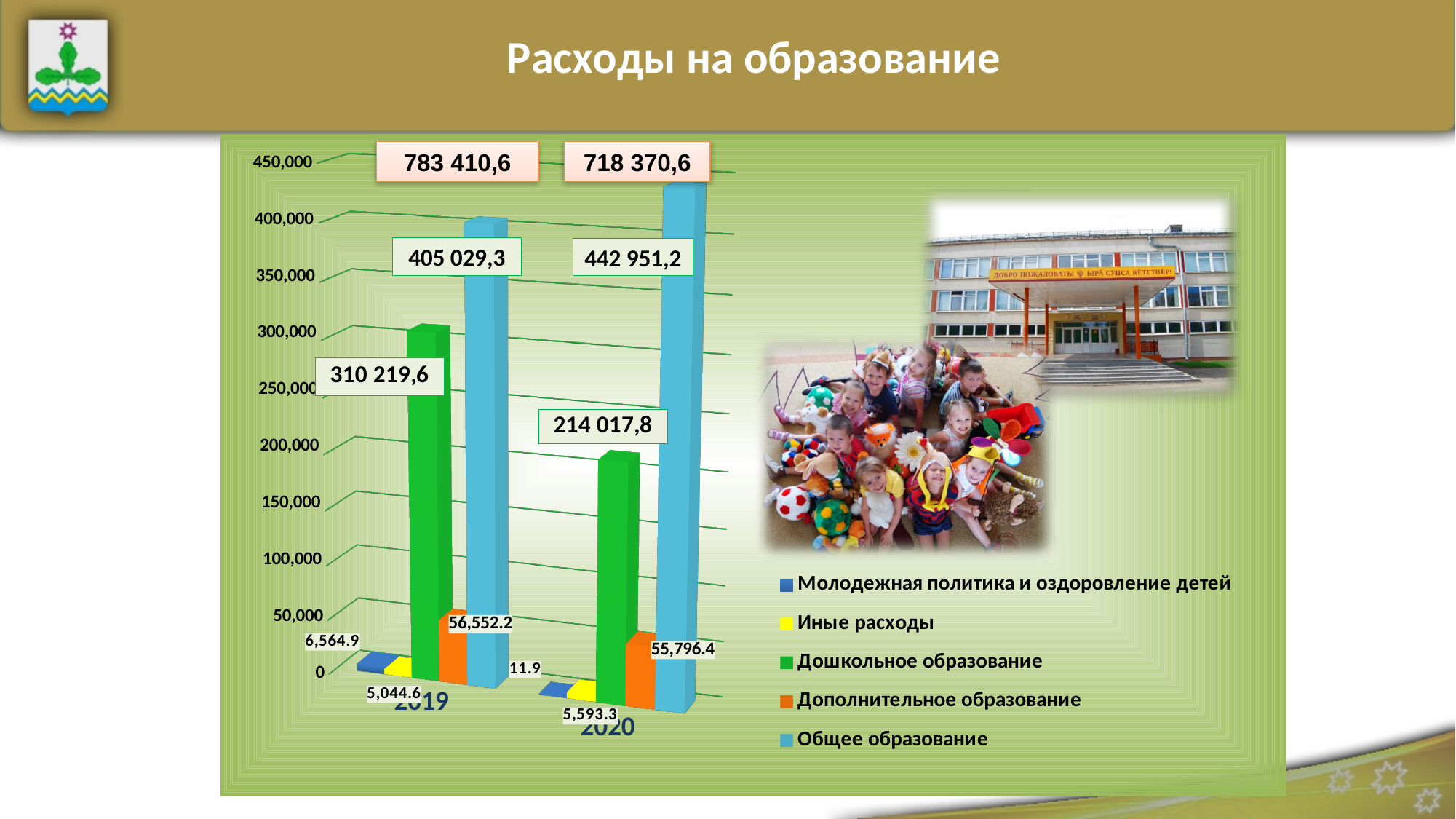
What is the total shown above the 2019 group of bars? 783 410,6 Which series has the lowest value in 2019? Иные расходы What is the value for Дошкольное образование in 2020? 214 017,8 Which series has the highest value in 2020? Общее образование What is the value for Общее образование in 2019? 405 029,3 Is the value for Общее образование in 2020 greater or less than 400,000? greater Which is larger: Дошкольное образование in 2019 or in 2020? 2019 What is the difference between Общее образование in 2020 and in 2019? 37 921,9 What kind of chart is shown on the slide? bar chart How many series does the legend list? 5 What is the value for Иные расходы in 2020? 5,593.3 What is the value for Дополнительное образование in 2019? 56,552.2